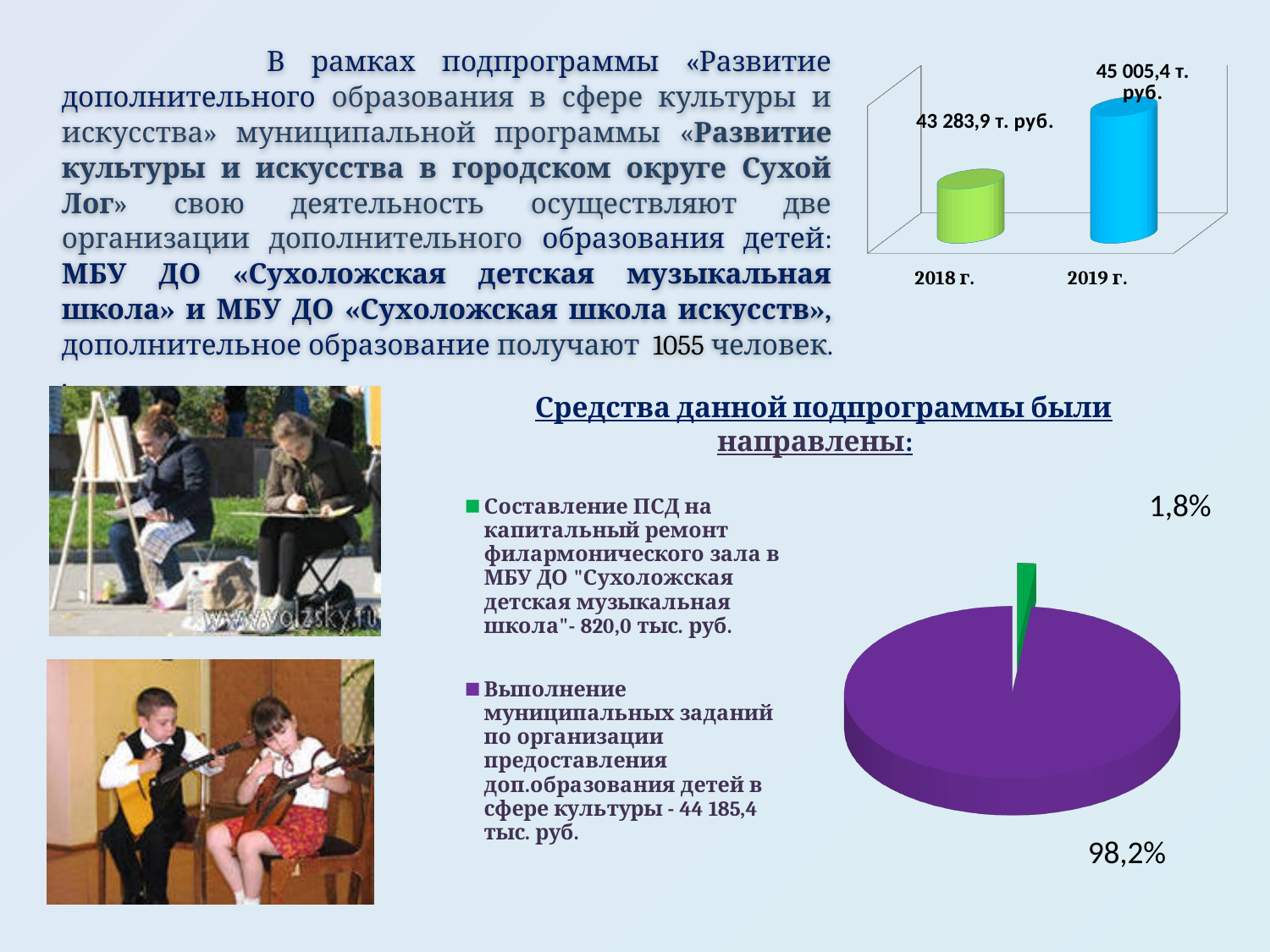
In the bar chart at the top right, by how much does the 2019 г. value exceed the 2018 г. value? 1 721,5 т. руб. In the bar chart at the top right, what is the value for 2019 г.? 45 005,4 т. руб. What kind of chart is shown at the top right of the slide? bar chart In the bar chart at the top right, which year has the lower value? 2018 г. In the bar chart at the top right, do the values rise or fall from 2018 г. to 2019 г.? rise In the bar chart at the top right, what is the value for 2018 г.? 43 283,9 т. руб. In the pie chart at the bottom right, how many entries does the legend list? 2 What kind of chart is shown at the bottom right of the slide? pie chart In the pie chart at the bottom right, what share is labelled for the green slice (Составление ПСД на капитальный ремонт филармонического зала)? 1,8% In the bar chart at the top right, which year has the higher value? 2019 г. In the bar chart at the top right, how many categories are shown? 2 In the pie chart at the bottom right, what share is labelled for the purple slice (Выполнение муниципальных заданий)? 98,2%